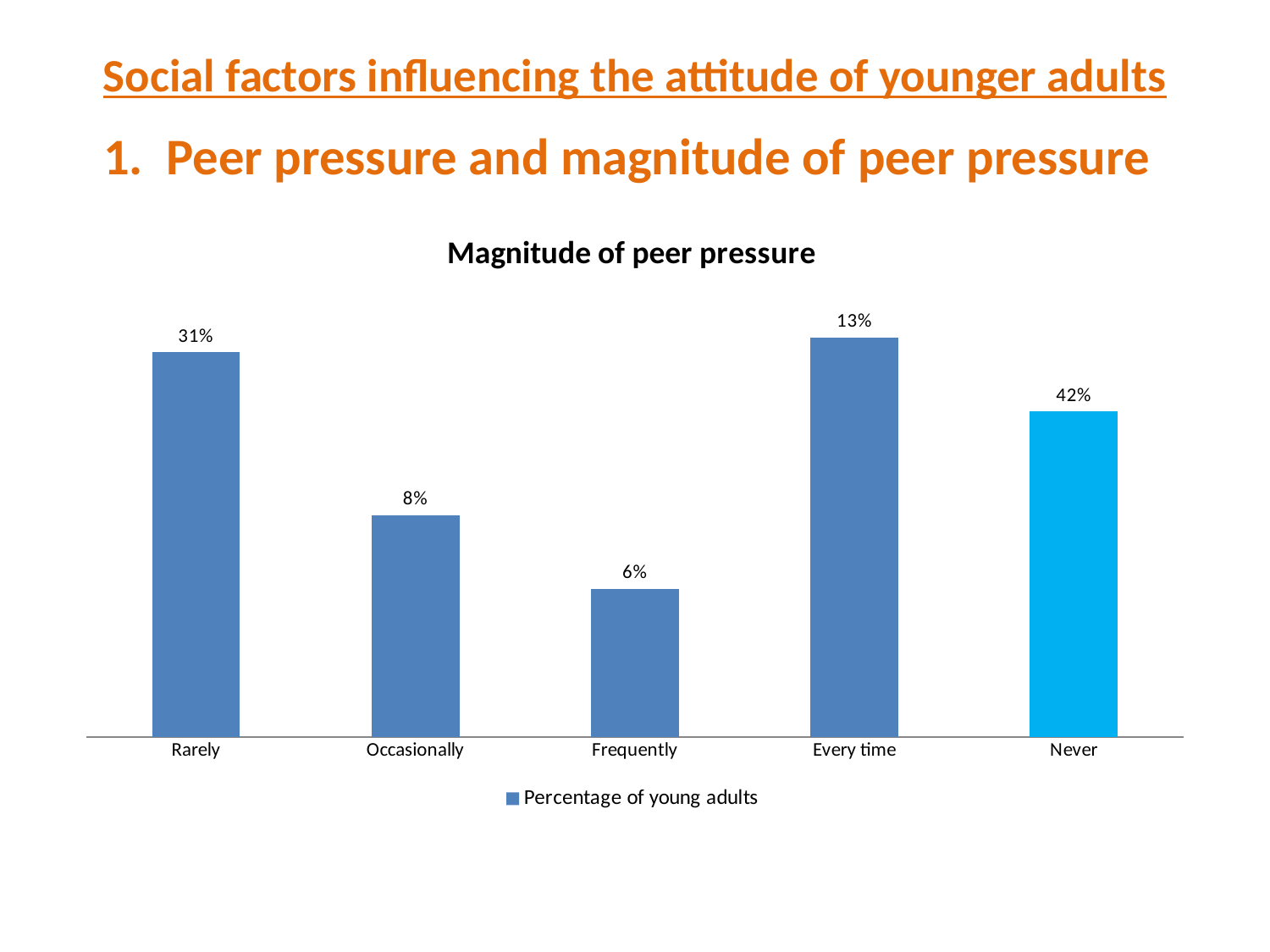
What is the value for Never? 42% What is the difference between the values for Rarely and Occasionally? 23% Which is larger, the value for Rarely or the value for Frequently? Rarely What is the value for Frequently? 6% What is the value for Occasionally? 8% What is the value for Rarely in the Magnitude of peer pressure chart? 31% Which category has the lowest value? Frequently How many categories are shown on the x axis? 5 What kind of chart is shown on the slide? Bar chart What is the title of the chart? Magnitude of peer pressure What is the difference between the values for Occasionally and Frequently? 2% What is the value for Every time? 13%